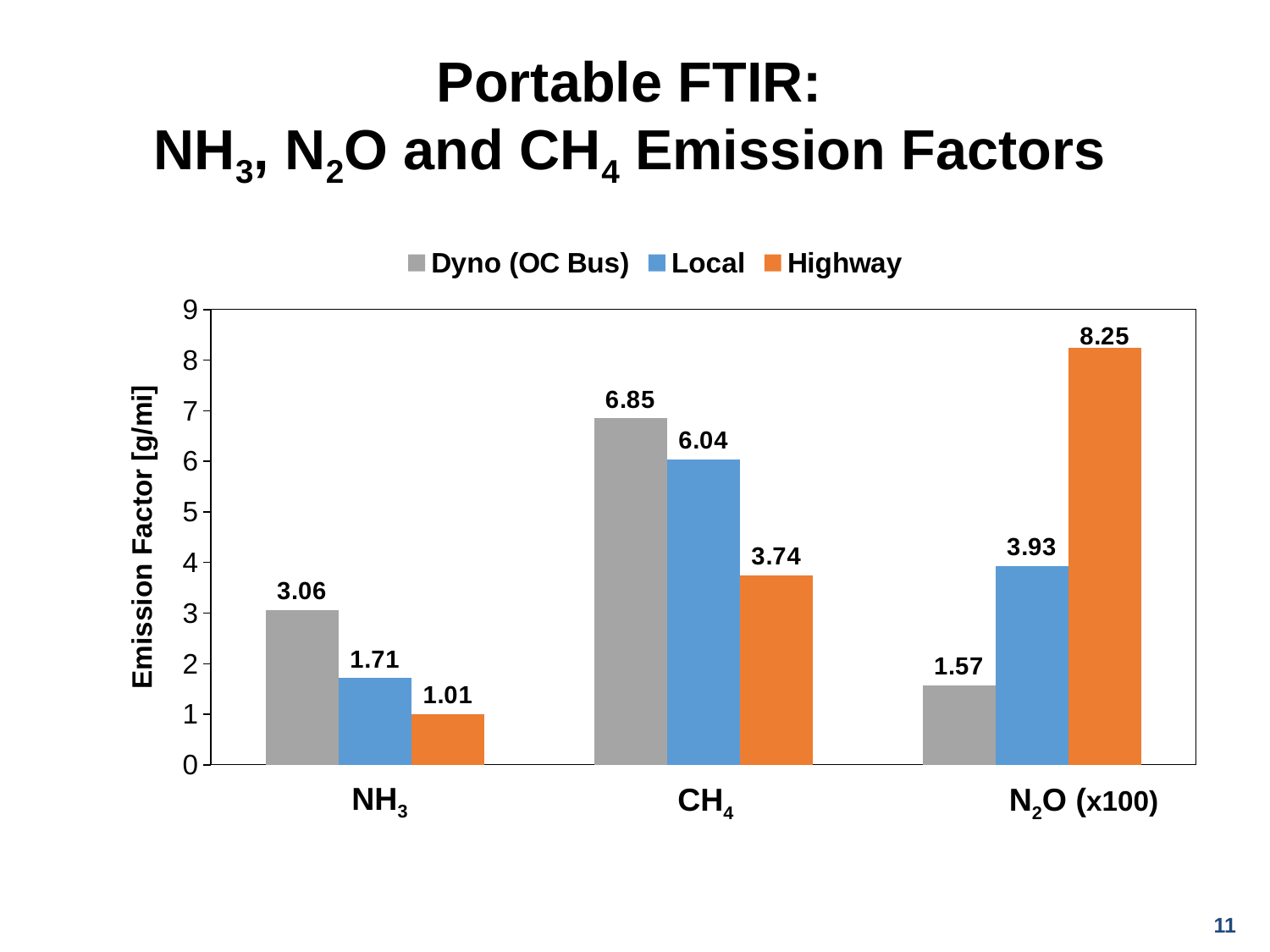
What is the Highway emission factor for N2O (x100)? 8.25 What is the difference between the Dyno (OC Bus) and Highway values for CH4? 3.11 What kind of chart is shown on the slide? Bar chart What is the Local emission factor for CH4? 6.04 What is the Dyno (OC Bus) emission factor for NH3? 3.06 Which series has the lowest value for N2O (x100)? Dyno (OC Bus) How many series does the legend list? 3 How many categories are shown on the x axis? 3 Which is larger for NH3: the Local value or the Highway value? Local Which series has the highest value for CH4? Dyno (OC Bus) What is the label of the y axis? Emission Factor [g/mi] Is the Highway value for N2O (x100) greater or less than 8? greater